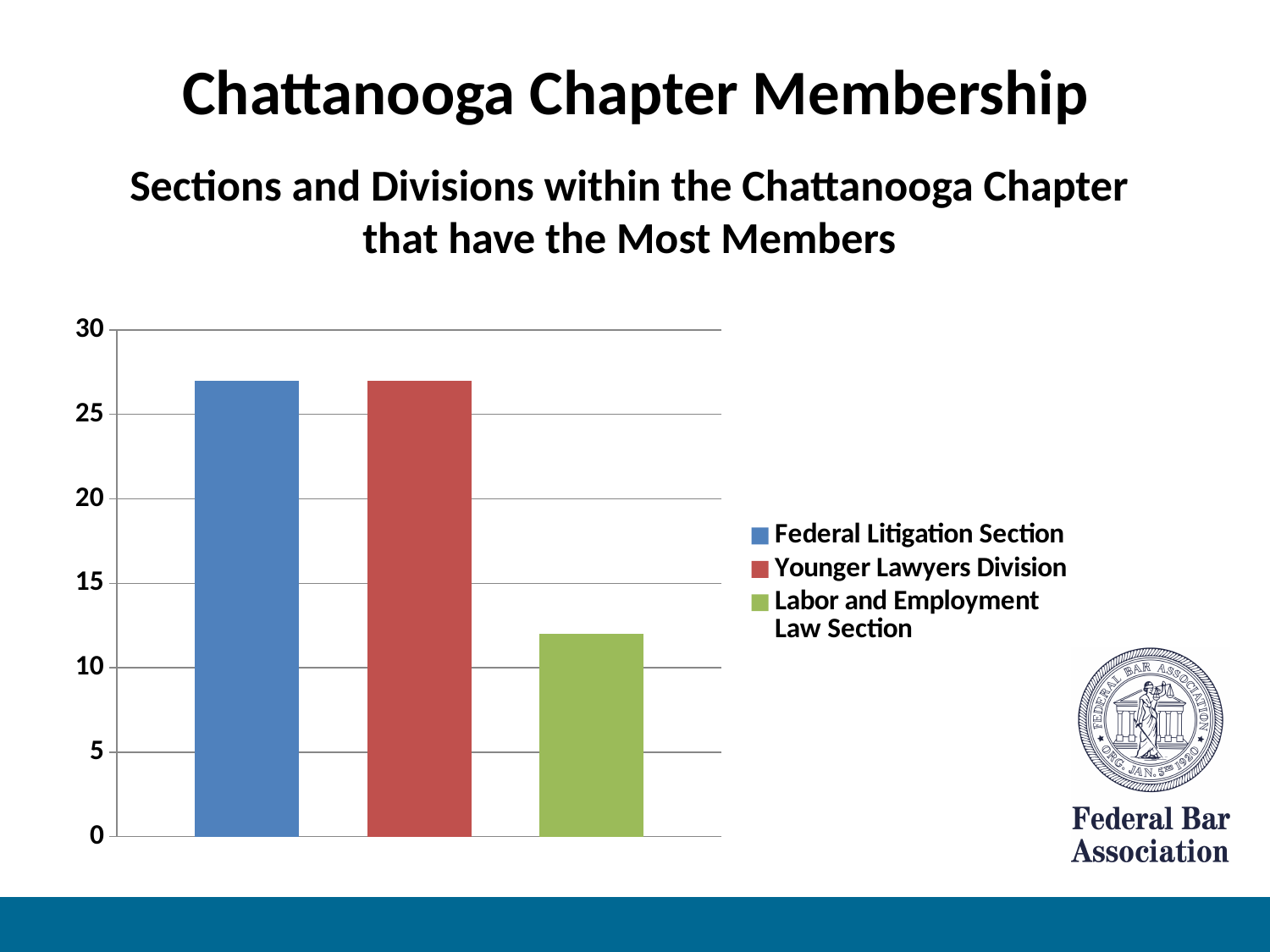
How many bars are plotted in the chart? 3 Is the value for the Younger Lawyers Division greater or less than 20? greater Which is larger, the value for the Federal Litigation Section or the Labor and Employment Law Section? Federal Litigation Section Which section or division has the fewest members? Labor and Employment Law Section Is the value for the Labor and Employment Law Section greater or less than 10? greater How many series does the legend list? 3 Is the value for the Labor and Employment Law Section greater or less than 15? less Which colour represents the Younger Lawyers Division in the legend? red What is the title of the chart? Sections and Divisions within the Chattanooga Chapter that have the Most Members What kind of chart is shown on the slide? bar chart